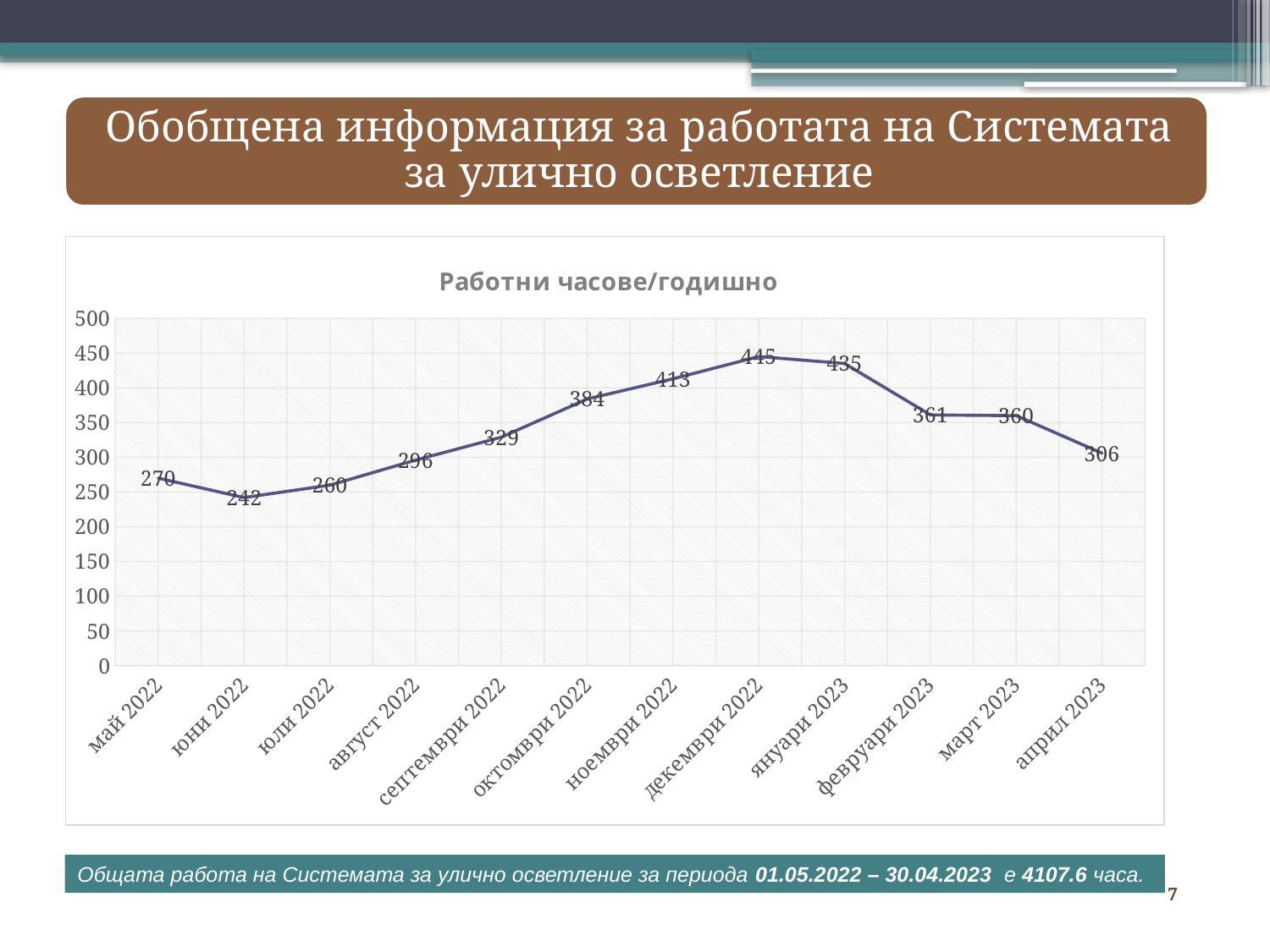
Which month has the lowest value? юни 2022 What is the difference between the values for декември 2022 and юни 2022? 203 What is the value for декември 2022? 445 Do the values rise or fall from юни 2022 to декември 2022? rise What kind of chart is shown? line chart Is the value for януари 2023 greater or less than 400? greater Which month has the highest value? декември 2022 How many months are plotted on the chart? 12 What is the value for юни 2022? 242 What is the value for април 2023? 306 What is the title of the chart? Работни часове/годишно Which is larger, the value for ноември 2022 or the value for октомври 2022? ноември 2022